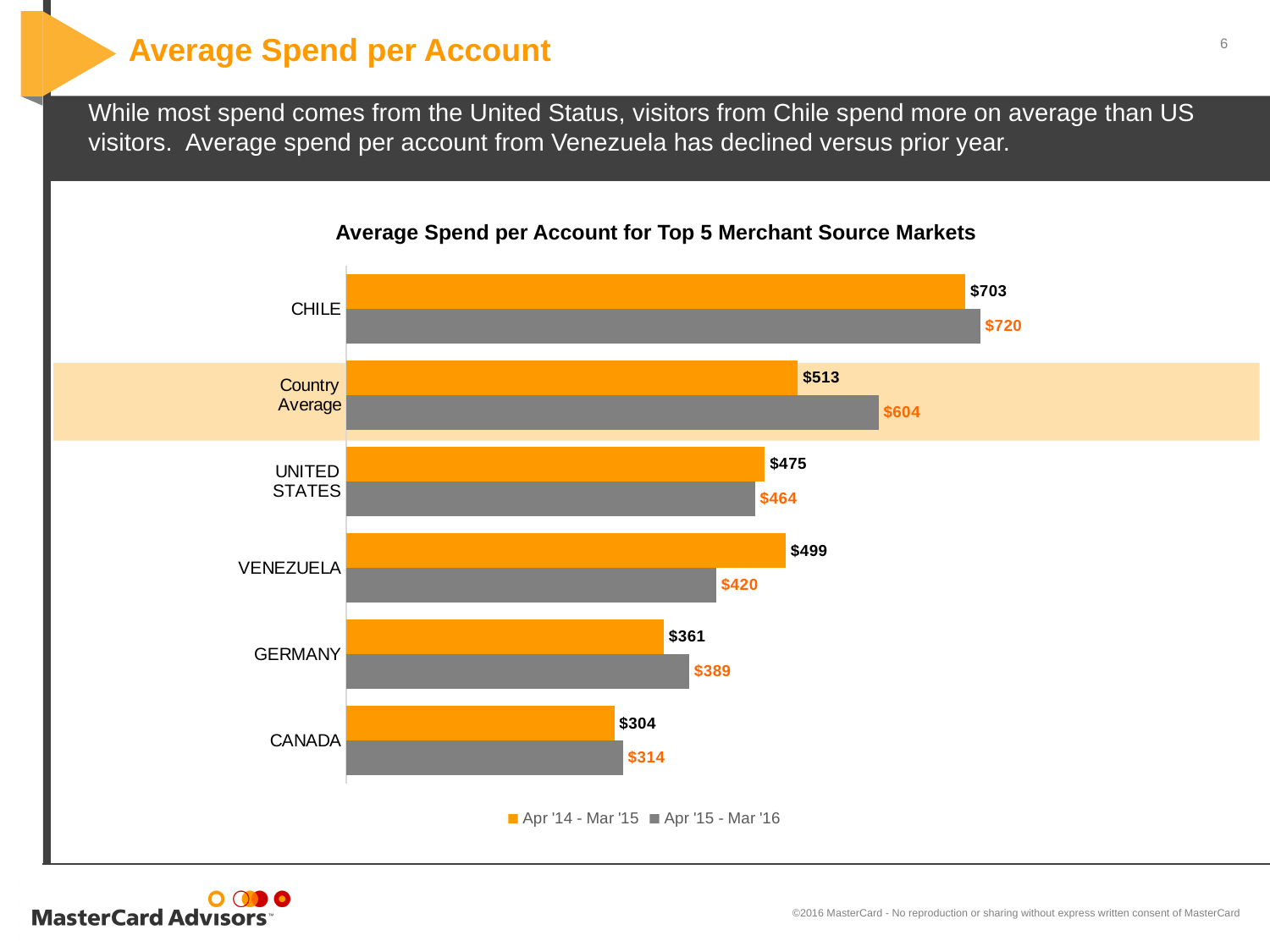
What kind of chart is shown on the slide? Bar chart Which is larger for the United States: the Apr '14 - Mar '15 value or the Apr '15 - Mar '16 value? Apr '14 - Mar '15 Which category has the lowest value in the Apr '14 - Mar '15 series? CANADA What is the average spend per account for Venezuela in Apr '14 - Mar '15? $499 Which category has the highest value in the Apr '15 - Mar '16 series? CHILE How many categories are shown on the chart? 6 What is the difference between the Apr '15 - Mar '16 and Apr '14 - Mar '15 values for Germany? $28 What is the title of the chart? Average Spend per Account for Top 5 Merchant Source Markets How many series does the legend list? 2 What is the Country Average value for Apr '15 - Mar '16? $604 What is the average spend per account for Chile in Apr '15 - Mar '16? $720 What is the difference between the Apr '15 - Mar '16 and Apr '14 - Mar '15 values for Venezuela? $79